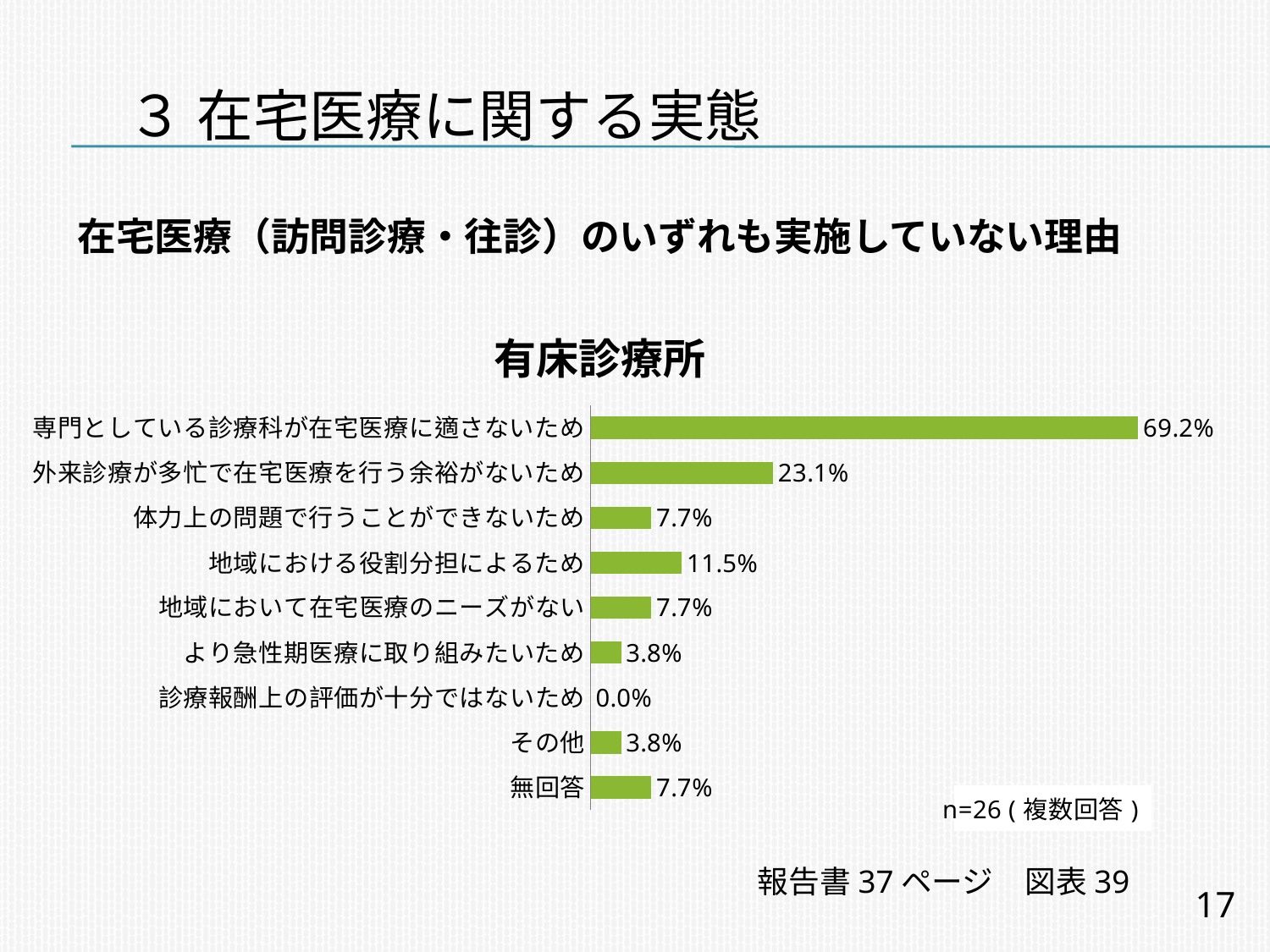
Which category has the lowest value? 診療報酬上の評価が十分ではないため What is the value for 専門としている診療科が在宅医療に適さないため? 69.2% What is the value for 地域における役割分担によるため? 11.5% Which category has the highest value? 専門としている診療科が在宅医療に適さないため What is the difference between the values for 地域における役割分担によるため and 体力上の問題で行うことができないため? 3.8% What is the value for 外来診療が多忙で在宅医療を行う余裕がないため? 23.1% What kind of chart is shown on the slide? Bar chart What is the value for 無回答? 7.7% What is the difference between the values for 専門としている診療科が在宅医療に適さないため and 外来診療が多忙で在宅医療を行う余裕がないため? 46.1% Which is larger, the value for 地域における役割分担によるため or the value for より急性期医療に取り組みたいため? 地域における役割分担によるため What is the value for 診療報酬上の評価が十分ではないため? 0.0% How many categories are shown in the chart? 9